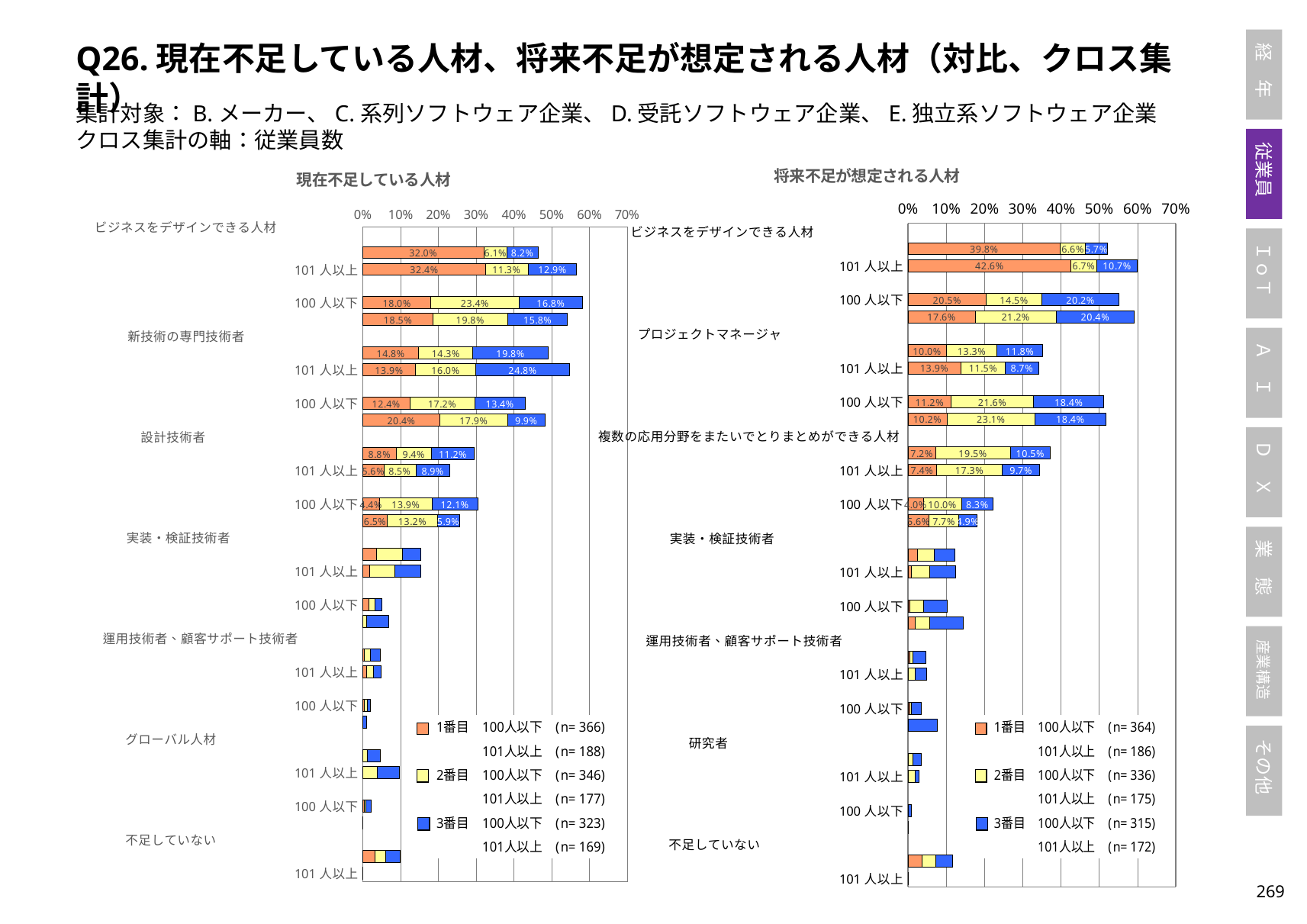
In the right chart (将来不足が想定される人材), what is the 1番目 value on the bar next to the 101 人以上 label under ビジネスをデザインできる人材? 42.6% In the right chart (将来不足が想定される人材), what is the total of the bar next to the 101 人以上 label under ビジネスをデザインできる人材 (42.6%, 6.7%, 10.7%)? 60.0% How many series does the legend of the left chart (現在不足している人材) list? 3 (1番目, 2番目, 3番目) What kind of chart is the left chart titled 現在不足している人材? Bar chart (stacked horizontal bars) In the left chart (現在不足している人材), what is the difference between the 1番目 value (32.0%) and the 3番目 value (8.2%) on the upper bar of ビジネスをデザインできる人材? 23.8 percentage points In the right chart (将来不足が想定される人材), what is the n value shown in the legend for 3番目 101人以上? n= 172 In the right chart (将来不足が想定される人材), what is the 1番目 value on the upper bar of ビジネスをデザインできる人材? 39.8% In the left chart (現在不足している人材), what is the n value shown in the legend for 1番目 100人以下? n= 366 What is the maximum value shown on the horizontal axis of the right chart (将来不足が想定される人材)? 70%